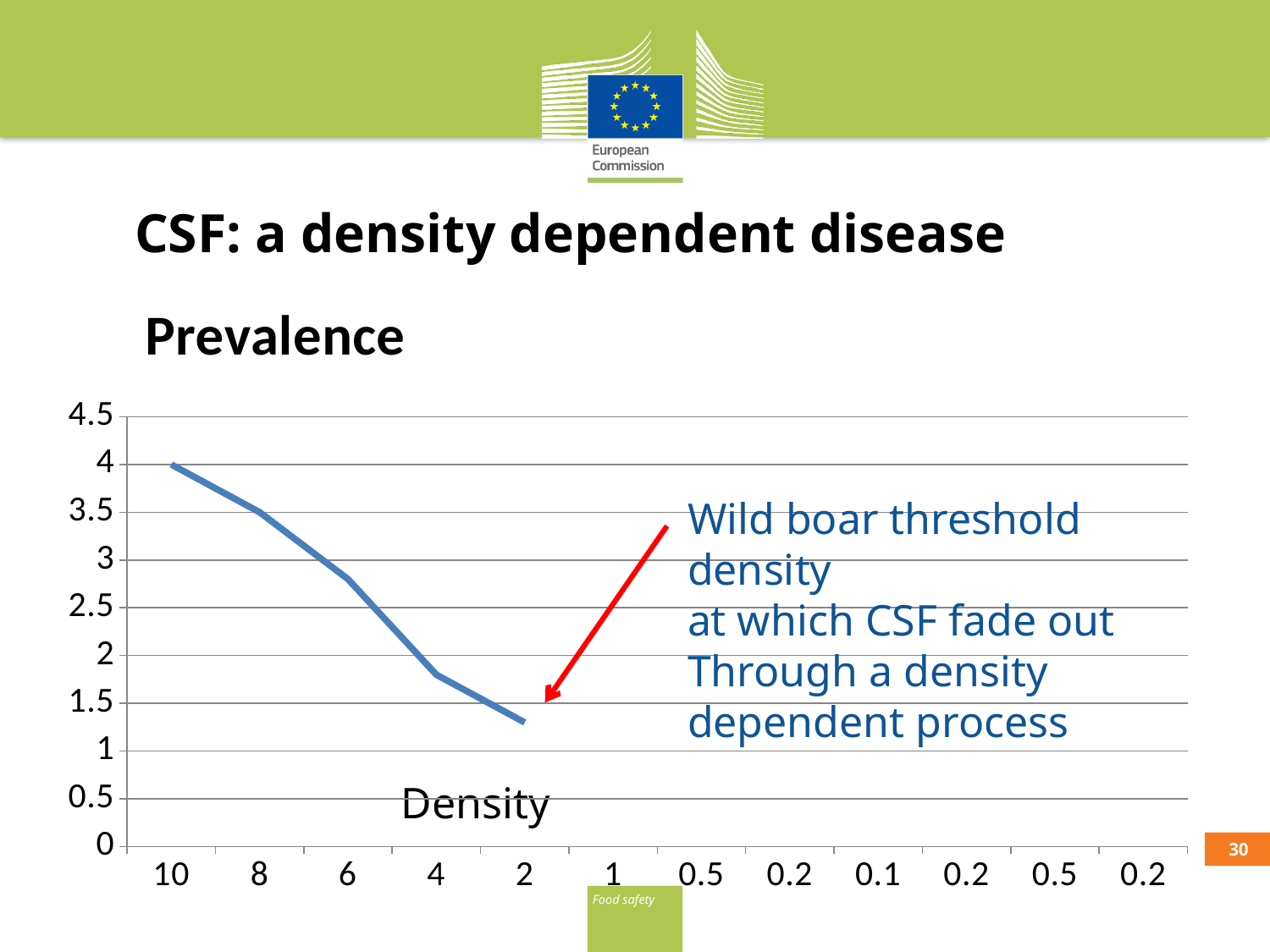
What kind of chart is shown on the slide? line chart What is the prevalence value at density 10? 4 Is the prevalence at density 2 greater or less than 1.5? less Is the prevalence at density 4 greater or less than 2? less Does prevalence rise or fall as density decreases from 10 to 2 along the x axis? fall What label is given to the vertical axis of the chart? Prevalence How many category labels are shown on the x axis? 12 Is the prevalence at density 6 greater or less than 3? less At which density is prevalence highest? 10 Which has the higher prevalence, density 10 or density 4? 10 At which density is the plotted prevalence lowest? 2